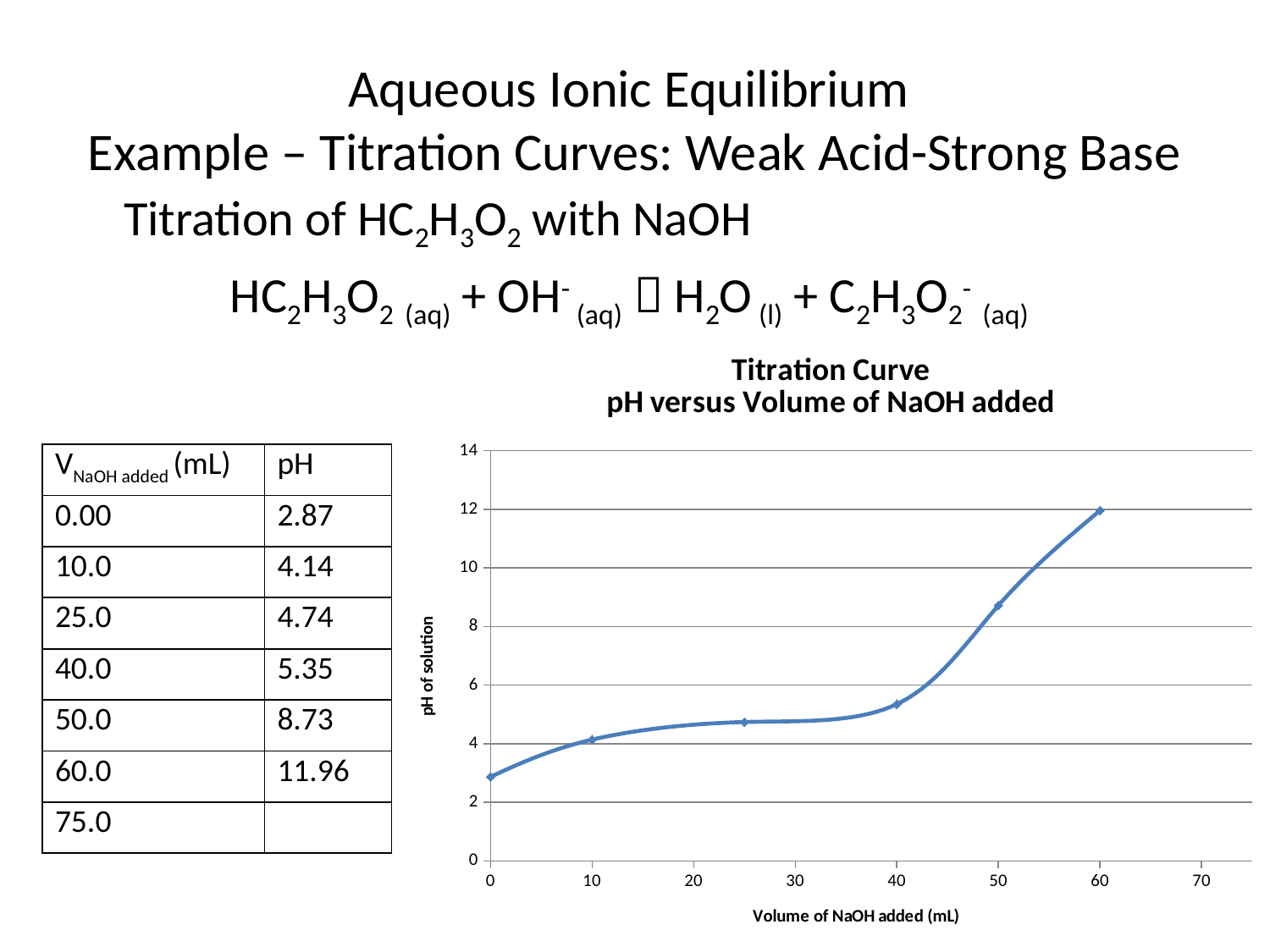
What is the pH of the solution when 60.0 mL of NaOH has been added? 11.96 What is the pH of the solution when 50.0 mL of NaOH has been added? 8.73 What is the label of the y axis of the chart? pH of solution At which volume of NaOH added is the plotted pH highest? 60.0 mL What is the title of the chart? Titration Curve pH versus Volume of NaOH added What is the pH of the solution when 0.00 mL of NaOH has been added? 2.87 At which volume of NaOH added is the plotted pH lowest? 0.00 mL Which has a higher pH: 25.0 mL of NaOH added or 40.0 mL of NaOH added? 40.0 mL How many data points are plotted on the titration curve? 6 What kind of chart is shown on the slide? line chart What is the difference in pH between 50.0 mL and 40.0 mL of NaOH added? 3.38 Does the pH rise or fall as the volume of NaOH added increases along the x axis? rise